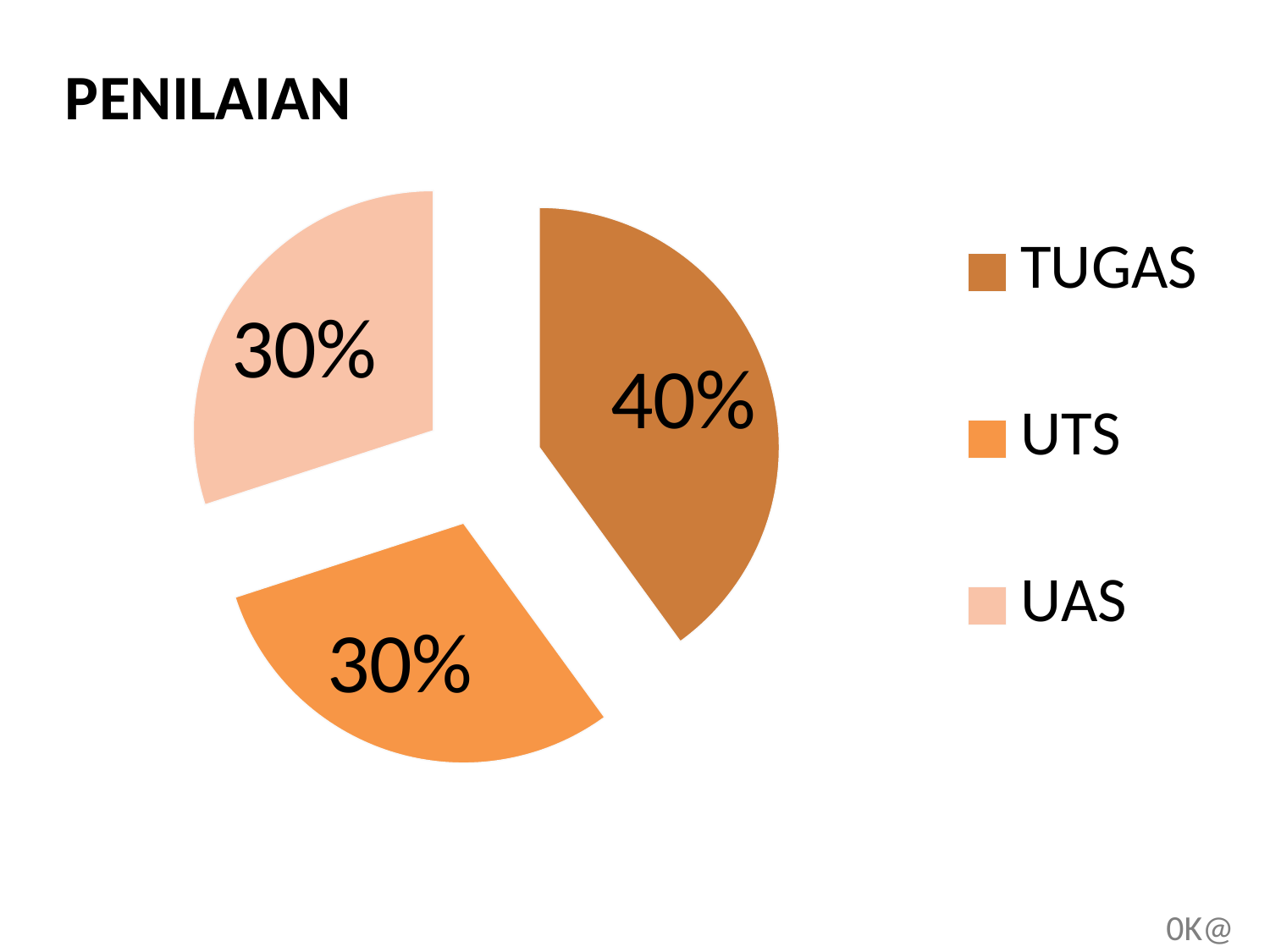
How many slices does the pie chart have? 3 What is the value for UAS? 30% Which is larger, the value for TUGAS or the value for UAS? TUGAS Which legend entry is shown with the darkest colour? TUGAS What type of chart is shown on the slide? pie chart What is the title of the slide containing the chart? PENILAIAN Is the value for TUGAS greater or less than 50%? less What is the value for UTS? 30% How many entries does the legend list? 3 What is the value for TUGAS? 40% What is the difference between the TUGAS and UTS values? 10% Which category has the largest share of the pie? TUGAS